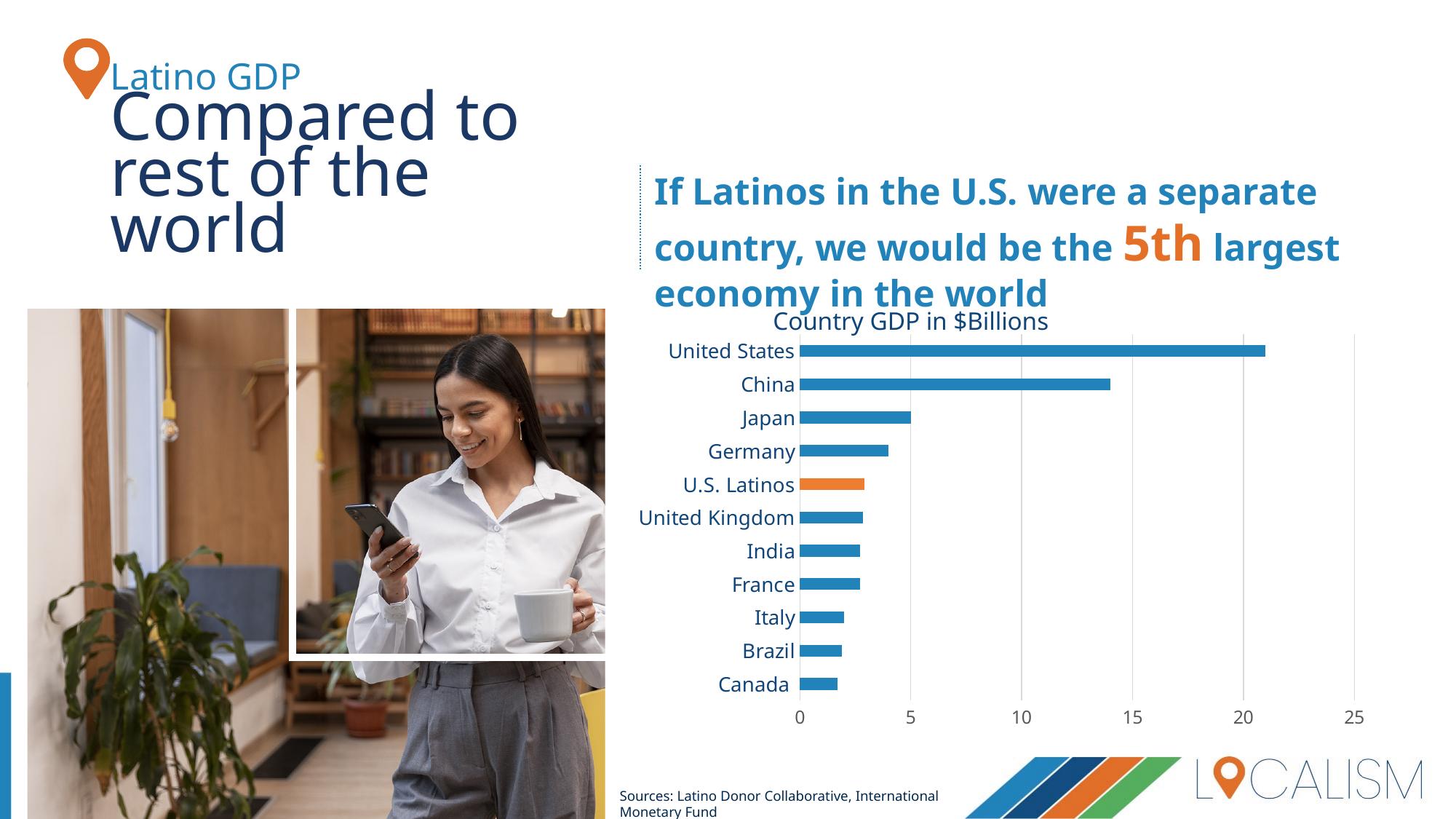
How many countries/categories are shown in the chart? 11 What is the title of the chart? Country GDP in $Billions Is the value for Canada greater or less than 5? less What type of chart is shown on the slide? Bar chart Is the value for United States greater or less than 20? greater Is the value for China greater or less than 15? less Which category has the highest GDP in the chart? United States Which category's bar is coloured orange in the chart? U.S. Latinos Which has a larger GDP, China or Japan? China Which has a larger GDP, Germany or U.S. Latinos? Germany